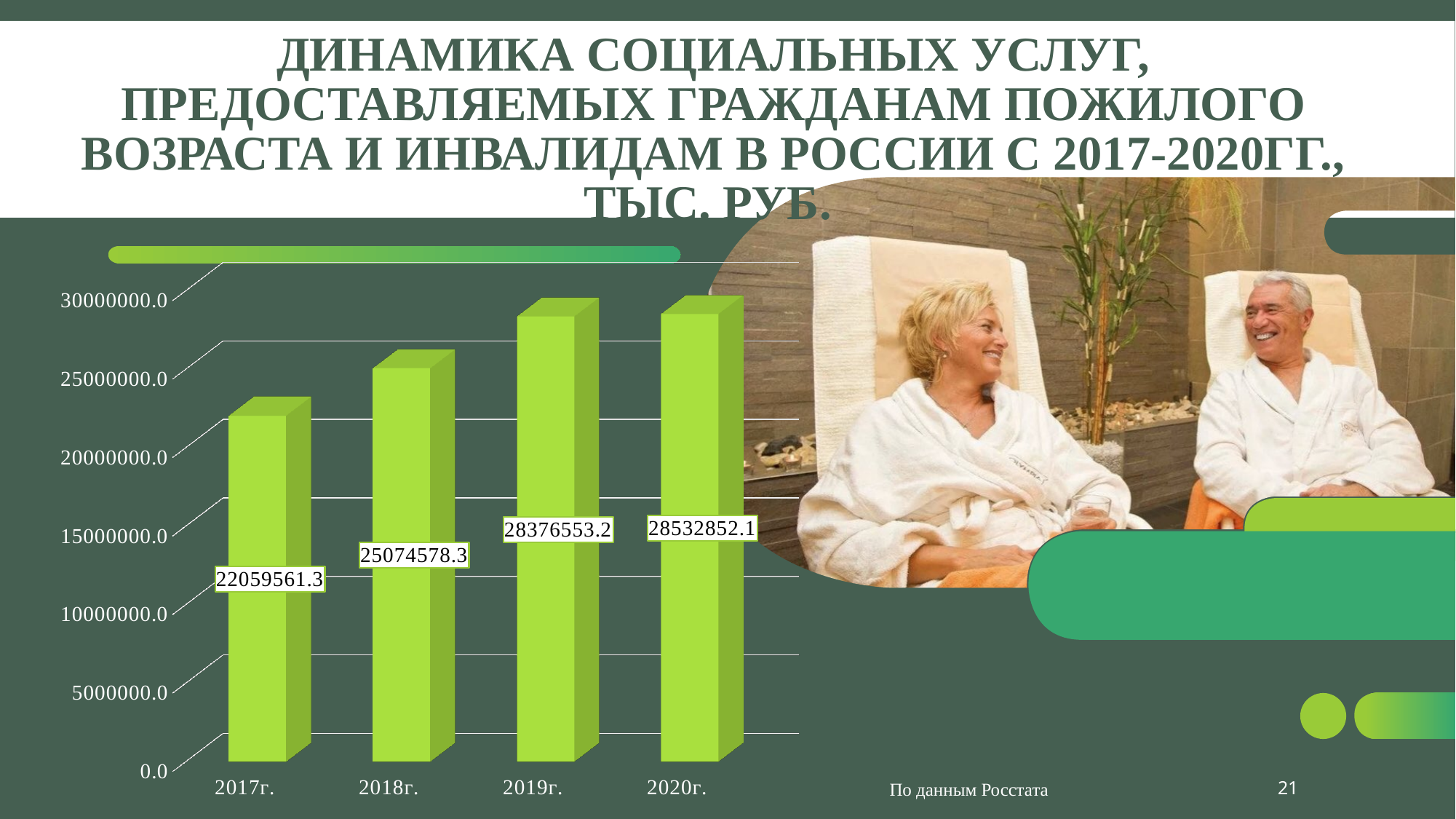
What is the value for 2020г.? 28532852.1 What is the value for 2017г.? 22059561.3 How many years are shown on the x axis? 4 Is the value for 2017г. greater or less than 20000000.0? greater Do the values rise or fall from 2017г. to 2020г.? rise Which year has the lowest value? 2017г. Which year has the highest value? 2020г. What is the difference between the values for 2018г. and 2017г.? 3015017.0 What is the difference between the values for 2020г. and 2017г.? 6473290.8 What is the value for 2019г.? 28376553.2 What is the value for 2018г.? 25074578.3 Which is larger, the value for 2018г. or the value for 2019г.? 2019г.